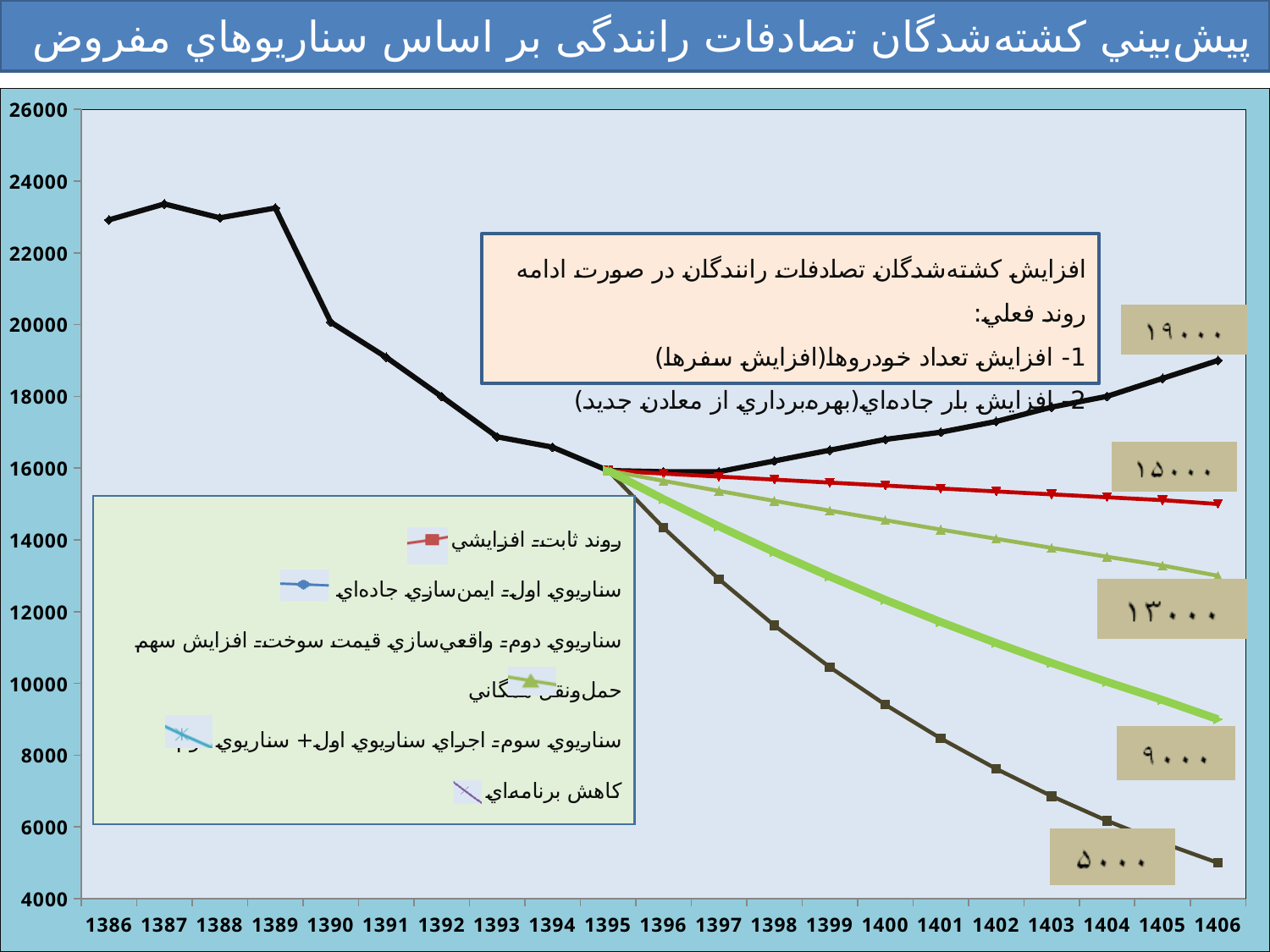
How many entries does the chart's legend list? 5 In 1406, is the black line higher or lower than the red line? higher How many years are shown on the x axis of the chart? 21 What is the difference between the highest (۱۹۰۰۰) and lowest (۵۰۰۰) end-of-line labels in 1406? 14000 What is the highest value labelled at the right end of the lines in 1406? ۱۹۰۰۰ What is the last year shown on the x axis? 1406 Is the value of the black line in 1387 greater or less than 22000? greater Does the black line rise or fall between 1389 and 1395? fall What is the first year shown on the x axis? 1386 Is the value of the black line in 1391 greater or less than 20000? less What kind of chart is shown on the slide? line chart What is the lowest value labelled at the right end of the lines in 1406? ۵۰۰۰